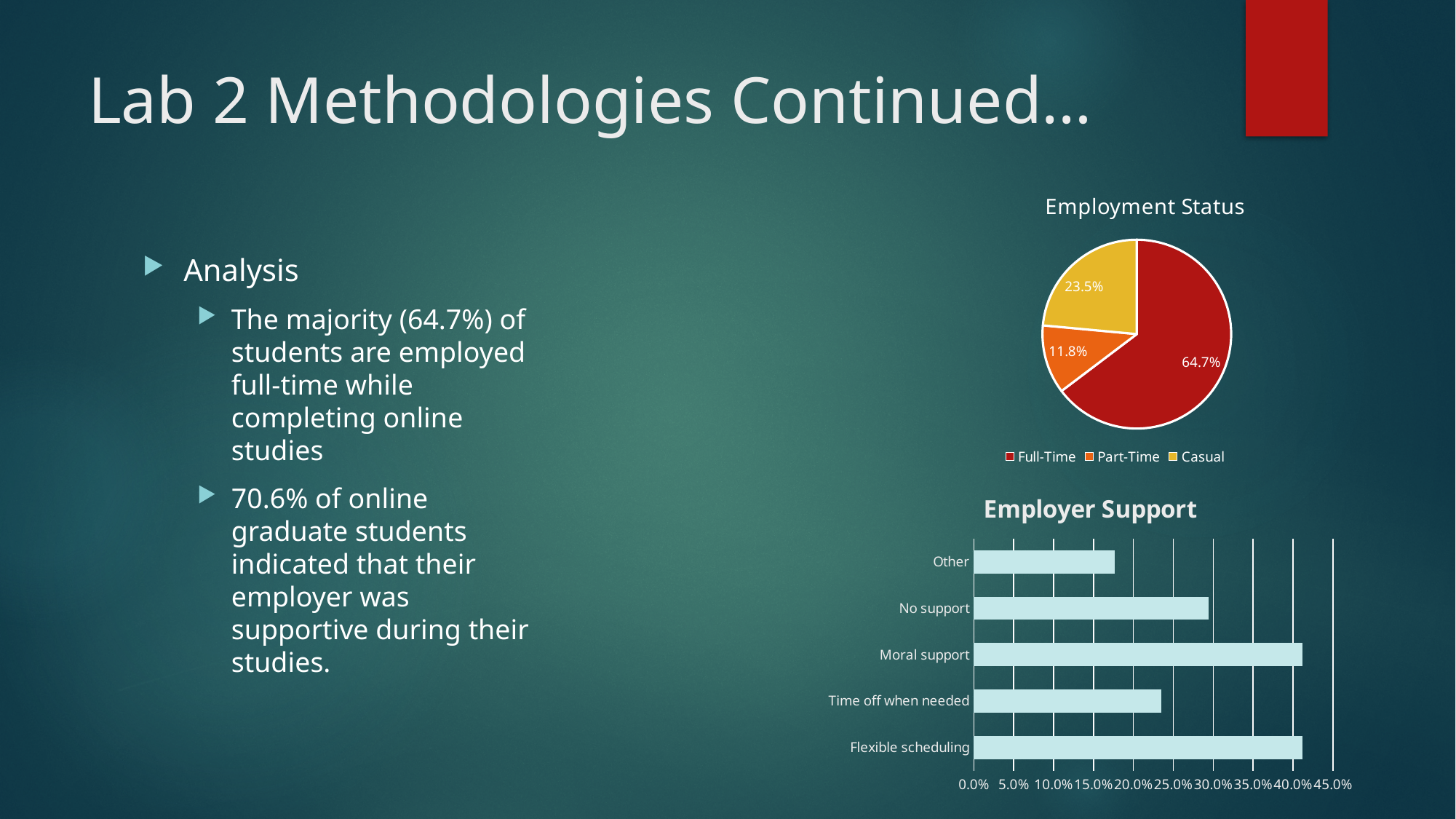
In the Employment Status pie chart, what percentage is shown for Part-Time? 11.8% In the Employment Status pie chart, what is the difference between the Full-Time and Casual percentages? 41.2% In the Employer Support bar chart, which category has the lowest value? Other How many entries does the legend of the Employment Status pie chart list? 3 In the Employment Status pie chart, what percentage is shown for Full-Time? 64.7% How many categories are shown in the Employer Support bar chart? 5 In the Employer Support bar chart, is the value for Other greater or less than 20.0%? less What type of chart is the Employer Support chart? Bar chart In the Employer Support bar chart, which is larger: No support or Time off when needed? No support In the Employment Status pie chart, what percentage is shown for Casual? 23.5% In the Employment Status pie chart, which category has the smallest slice? Part-Time In the Employer Support bar chart, is the value for Flexible scheduling greater or less than 35.0%? greater